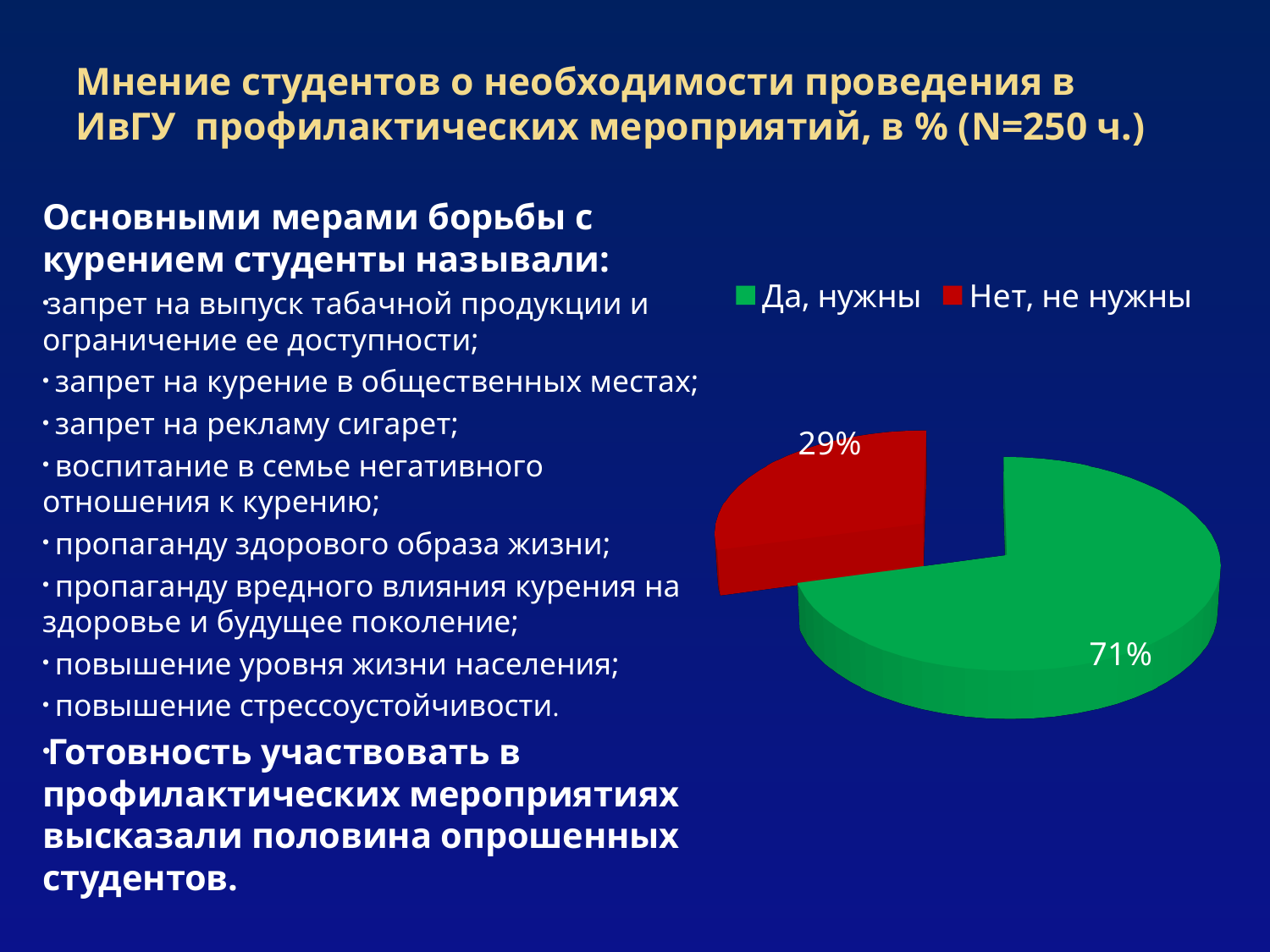
Which is larger: the "Да, нужны" slice or the "Нет, не нужны" slice? Да, нужны Which slice of the pie is the smallest? Нет, не нужны What share of the pie does "Да, нужны" take? 71% What colour is the "Нет, не нужны" slice? red What colour is the "Да, нужны" slice? green Which slice of the pie is the largest? Да, нужны How many slices does the pie chart have? 2 What share of the pie does "Нет, не нужны" take? 29% What is the difference in percentage points between the "Да, нужны" and "Нет, не нужны" slices? 42 What kind of chart is shown on the slide? pie chart How many entries does the legend list? 2